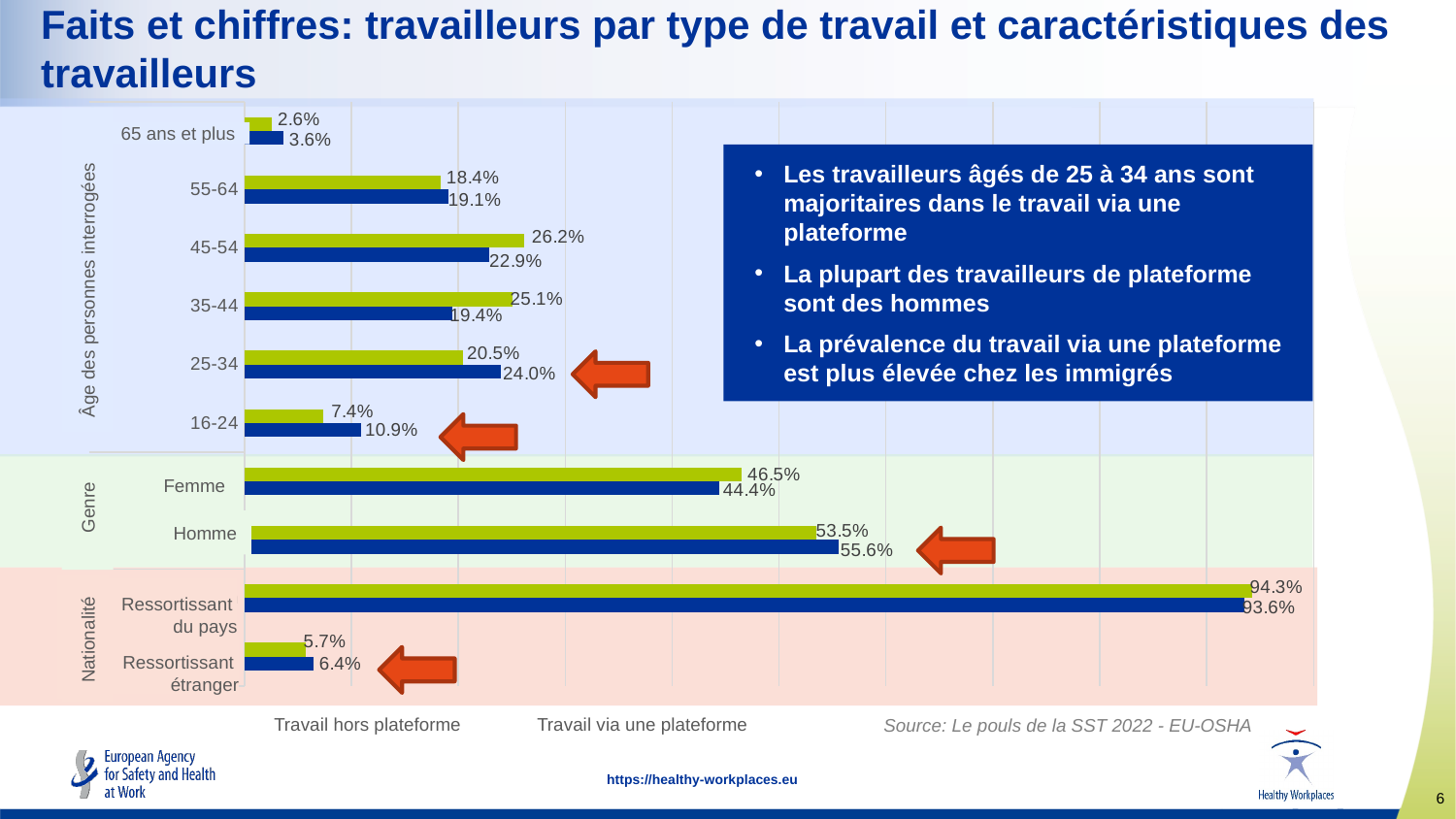
What is the difference between the 'Travail hors plateforme' and 'Travail via une plateforme' values for the 35-44 age group? 5.7% What is the difference between the 'Travail via une plateforme' and 'Travail hors plateforme' values for 'Homme'? 2.1% How many categories are plotted on the chart? 10 What is the value for 'Travail hors plateforme' in the 45-54 age group? 26.2% Among the age groups, which has the lowest value for 'Travail hors plateforme'? 65 ans et plus What is the value for 'Travail via une plateforme' for 'Ressortissant étranger'? 6.4% What is the value for 'Travail via une plateforme' in the 25-34 age group? 24.0% What kind of chart is shown on the slide? Bar chart Among the age groups, which has the highest value for 'Travail via une plateforme'? 25-34 For 'Femme', which is larger: 'Travail hors plateforme' or 'Travail via une plateforme'? Travail hors plateforme How many series does the legend list? 2 What is the source cited for the chart? Le pouls de la SST 2022 - EU-OSHA